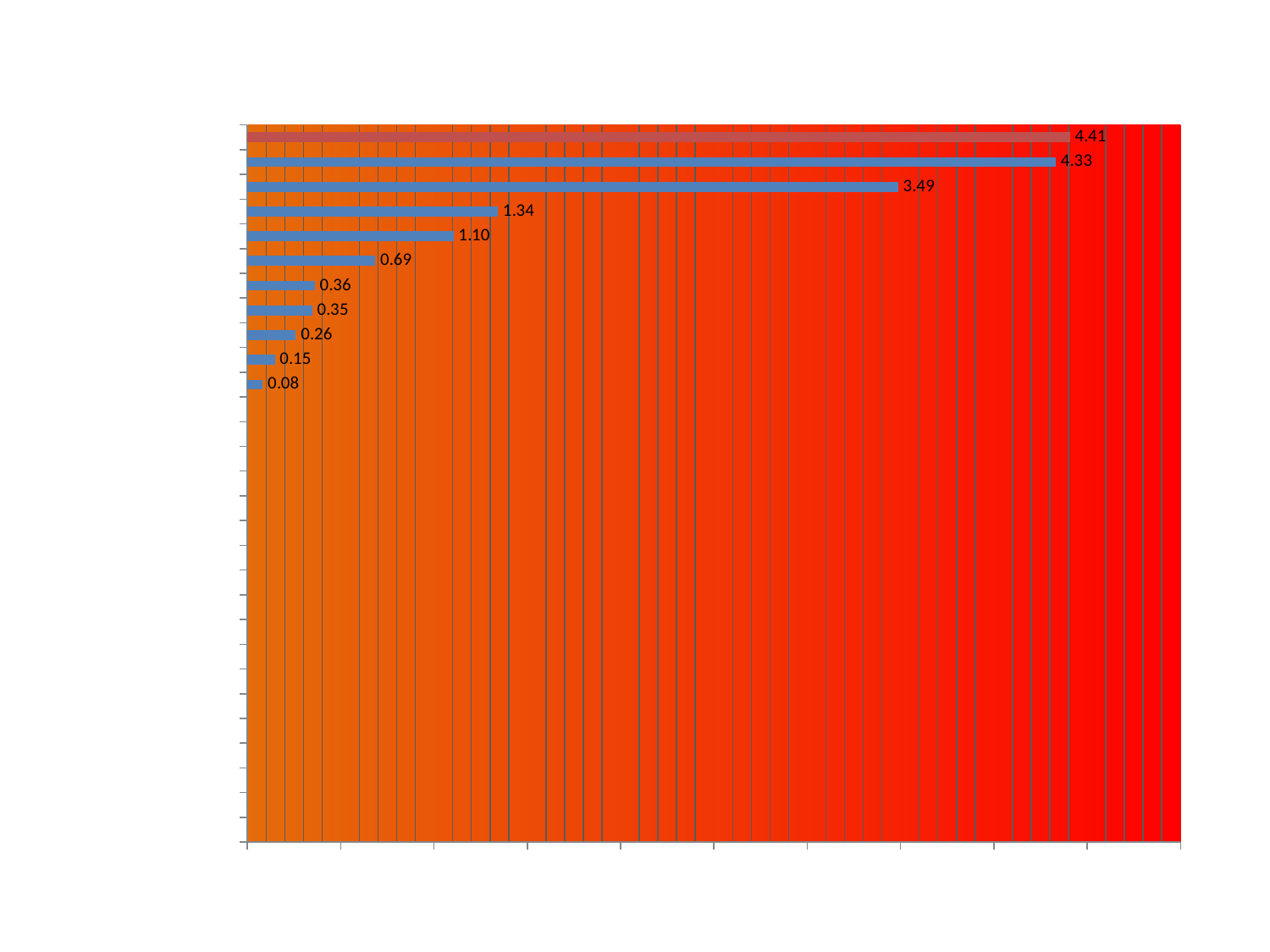
What is the difference between the top bar (4.41) and the second bar (4.33)? 0.08 Do the bar values increase or decrease going from the top of the chart to the bottom? decrease What is the highest value shown in the chart? 4.41 What is the lowest value shown in the chart? 0.08 How many bars are plotted in the chart? 11 Which bar is coloured differently from the other bars? the topmost bar (4.41) What is the value of the bottom bar in the chart? 0.08 What is the value of the topmost bar in the chart? 4.41 What is the difference between the third bar (3.49) and the fourth bar (1.34)? 2.15 What kind of chart is shown on the slide? bar chart What is the value of the third bar from the top? 3.49 Which is larger, the value of the fifth bar from the top or the sixth bar from the top? the fifth bar (1.10)